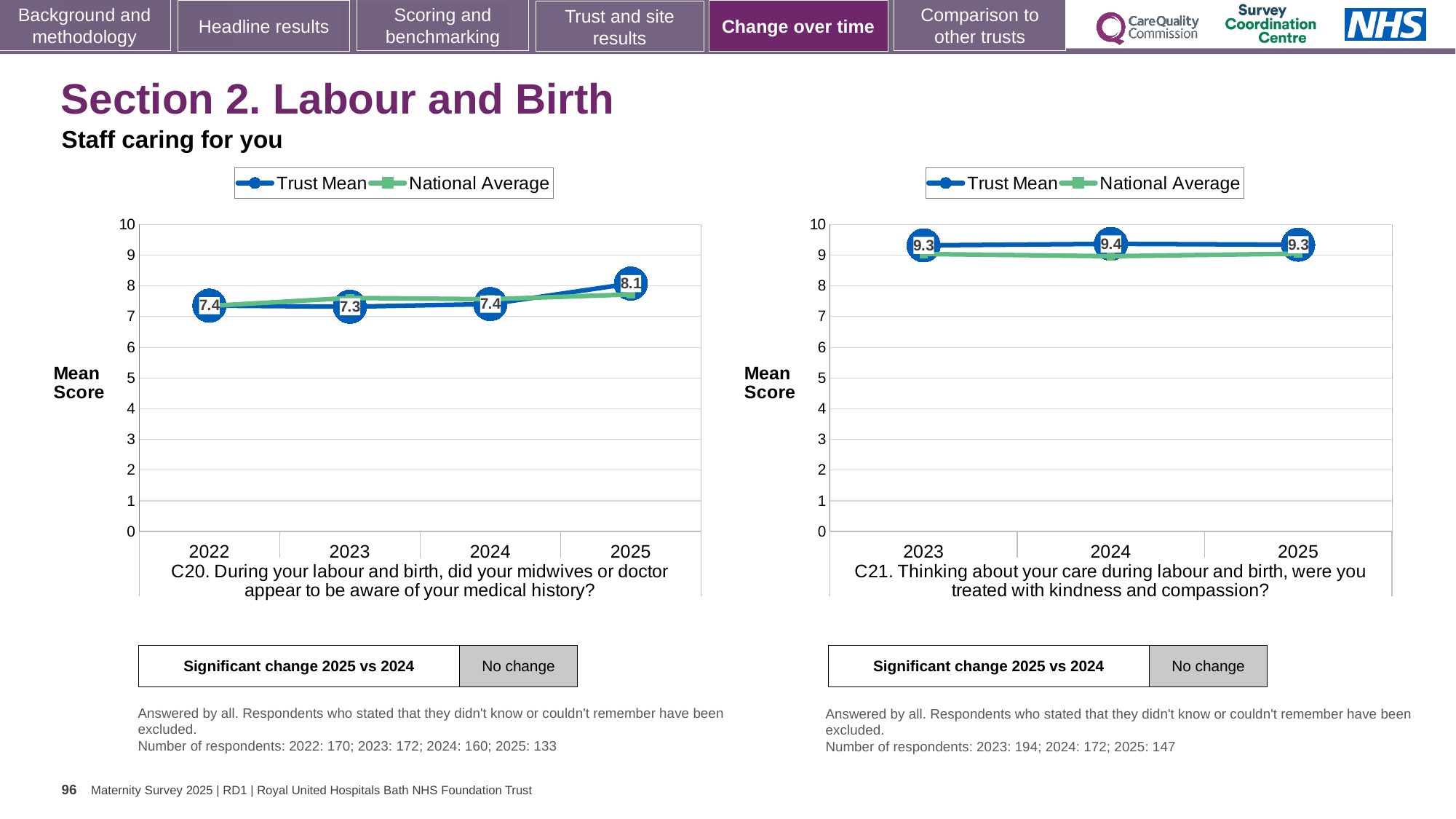
On the C21 chart (right), which is larger: the Trust Mean for 2024 or the Trust Mean for 2025? 2024 How many years are plotted on the C20 chart (left)? 4 On the C20 chart (left), does the Trust Mean rise or fall from 2024 to 2025? Rise On the C20 chart (left), which year has the highest Trust Mean? 2025 How many series does the legend of the C21 chart (right) list? 2 On the C21 chart (right), is the National Average for 2023 greater or less than 8? greater On the C20 chart (left), what is the Trust Mean for 2023? 7.3 On the C21 chart (right), what is the Trust Mean for 2024? 9.4 On the C20 chart (left), what is the difference between the Trust Mean for 2025 and the Trust Mean for 2024? 0.7 On the C20 chart (left), which year has the lowest Trust Mean? 2023 On the C20 chart (left), what is the Trust Mean for 2025? 8.1 What kind of chart is the C20 chart (left)? Line chart